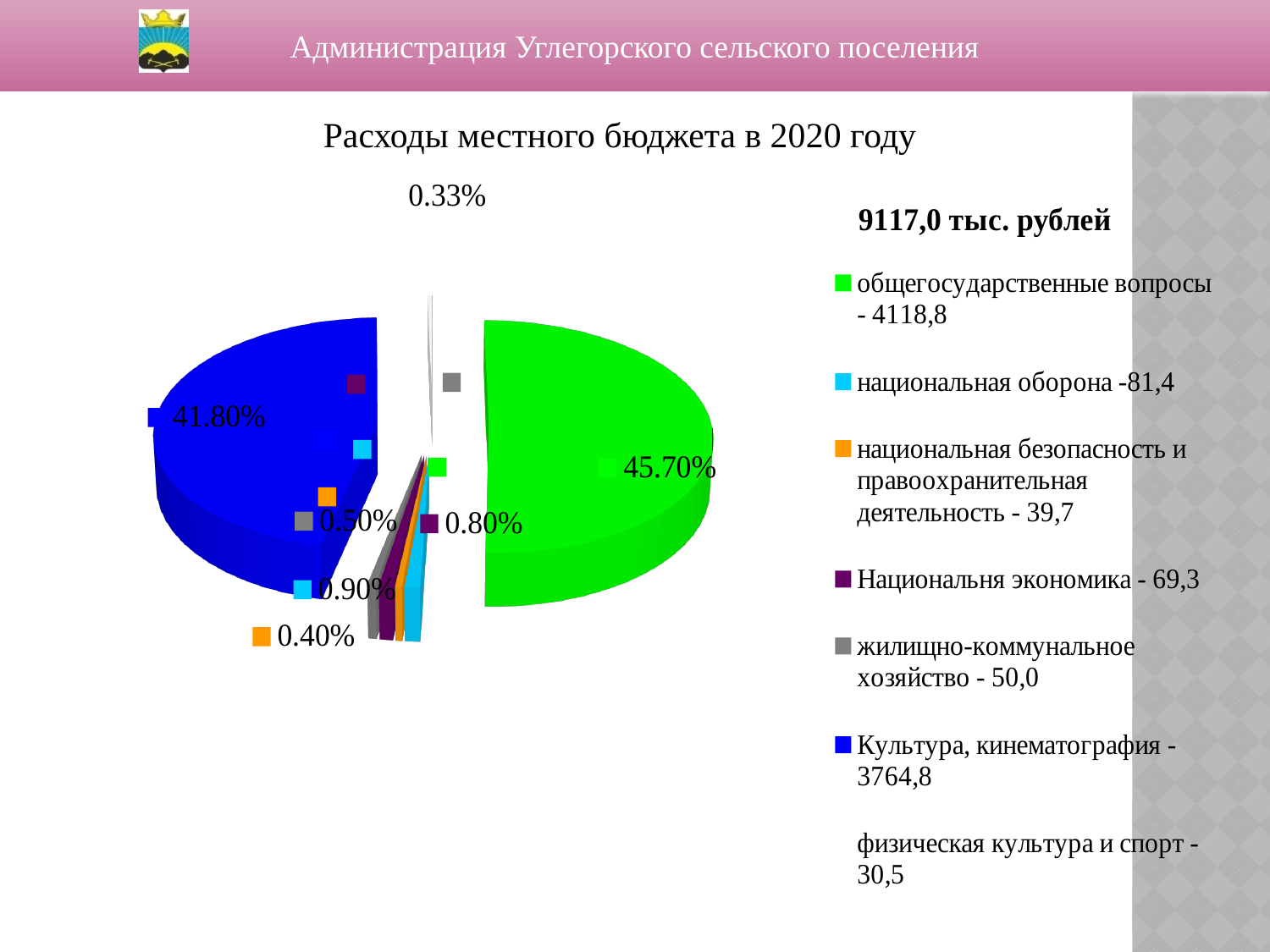
Which category has the largest slice of the pie? общегосударственные вопросы What is the difference in percentage points between the общегосударственные вопросы slice and the Культура, кинематография slice? 3.90% What percentage share does the slice for общегосударственные вопросы have? 45.70% Which slice is larger: национальная оборона or Национальня экономика? национальная оборона Which category has the smallest slice of the pie? физическая культура и спорт How many categories does the pie chart have? 7 What percentage share does the slice for Культура, кинематография have? 41.80% What is the chart's title? Расходы местного бюджета в 2020 году What percentage share does the slice for национальная безопасность и правоохранительная деятельность have? 0.40% What kind of chart is shown on the slide? pie chart What percentage share does the slice for жилищно-коммунальное хозяйство have? 0.50% What amount is listed in the legend for национальная оборона? 81,4